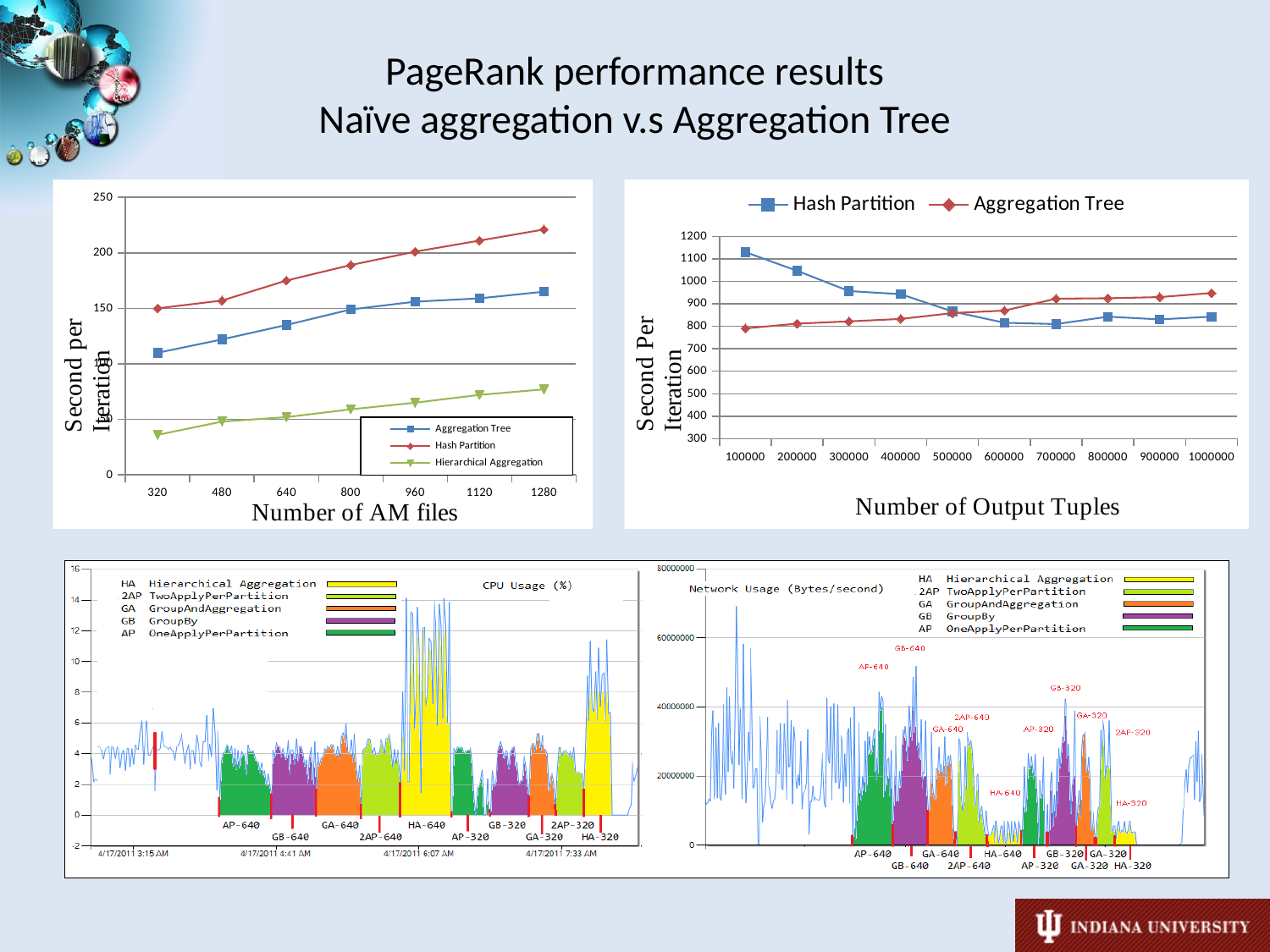
In the top-left chart (Number of AM files), which series has the lowest Second per Iteration across all AM file counts? Hierarchical Aggregation In the top-left chart (Number of AM files), is the Hash Partition value at 1280 AM files greater or less than 200? greater In the top-right chart (Number of Output Tuples), which series is larger at 1000000 output tuples, Hash Partition or Aggregation Tree? Aggregation Tree In the top-left chart (Number of AM files), how many values of Number of AM files are plotted on the x axis? 7 In the top-left chart (Number of AM files), which series has the highest Second per Iteration at 1280 AM files? Hash Partition In the top-left chart (Number of AM files), is the Hierarchical Aggregation value at 320 AM files greater or less than 50? less In the bottom-left chart (CPU Usage), how many entries does the legend list? 5 In the top-left chart (Number of AM files), do the Aggregation Tree values rise or fall as the Number of AM files increases? rise In the top-right chart (Number of Output Tuples), which series is larger at 100000 output tuples, Hash Partition or Aggregation Tree? Hash Partition In the top-right chart (Number of Output Tuples), is the Hash Partition value at 100000 output tuples greater or less than 1000? greater In the top-right chart (Number of Output Tuples), do the Hash Partition values rise or fall as the Number of Output Tuples increases? fall In the top-left chart (Number of AM files), how many series does the legend list? 3